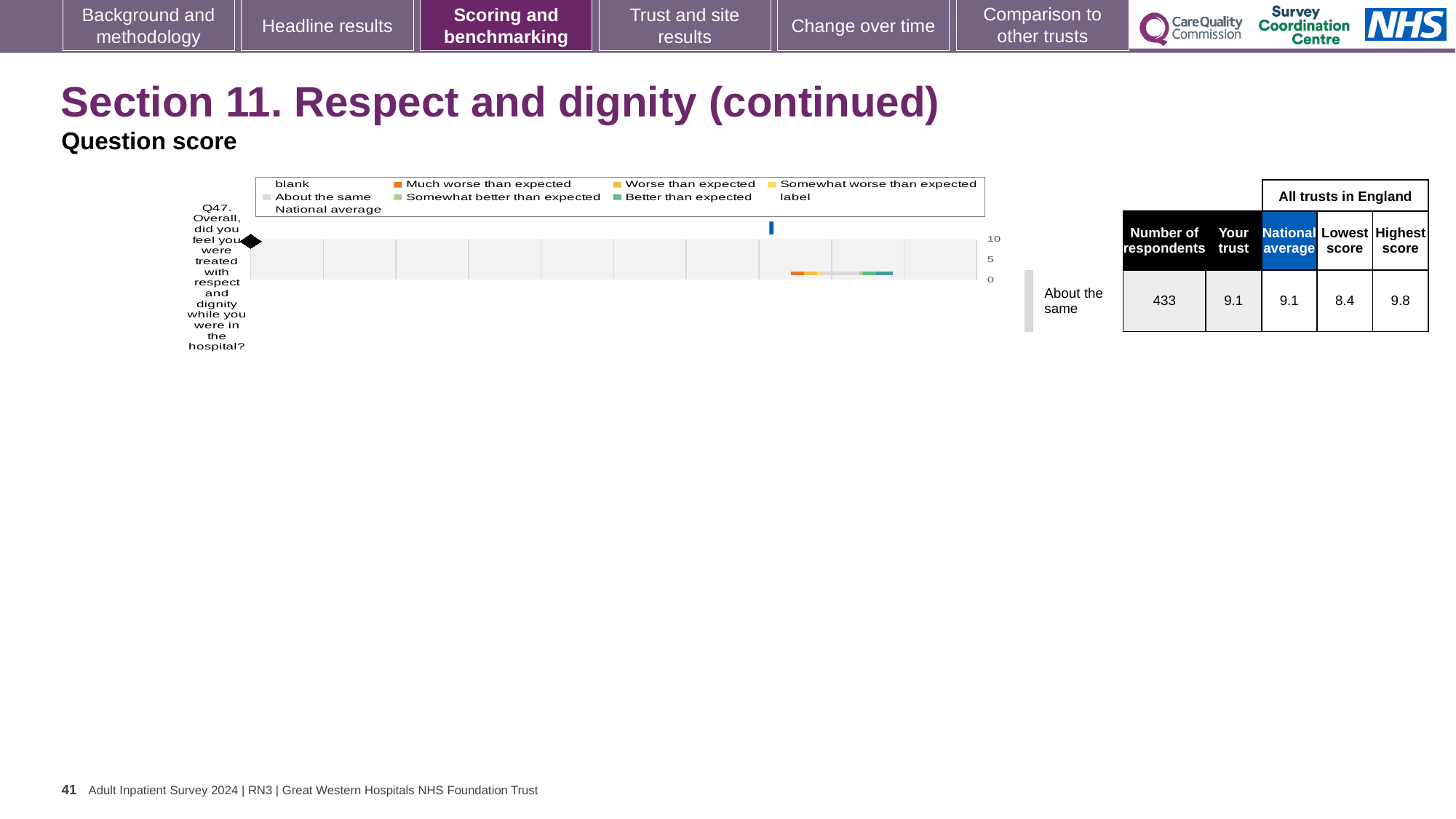
How many survey questions are plotted in the chart on this slide? 1 According to the table, what is the 'Your trust' score for Q47? 9.1 According to the table, what is the highest score among all trusts in England for Q47? 9.8 What benchmarking category is the trust's result for Q47 labelled as? About the same According to the table, what is the national average score for Q47? 9.1 What is the difference between the highest score and the lowest score for Q47 in the table? 1.4 How many respondents answered Q47 according to the table? 433 What kind of chart is shown on the slide for Q47? bar chart Is the 'Your trust' score for Q47 higher than, lower than, or the same as the national average? the same According to the table, what is the lowest score among all trusts in England for Q47? 8.4 Which question number is plotted in the chart? Q47 What is the difference between the highest score and the 'Your trust' score for Q47? 0.7